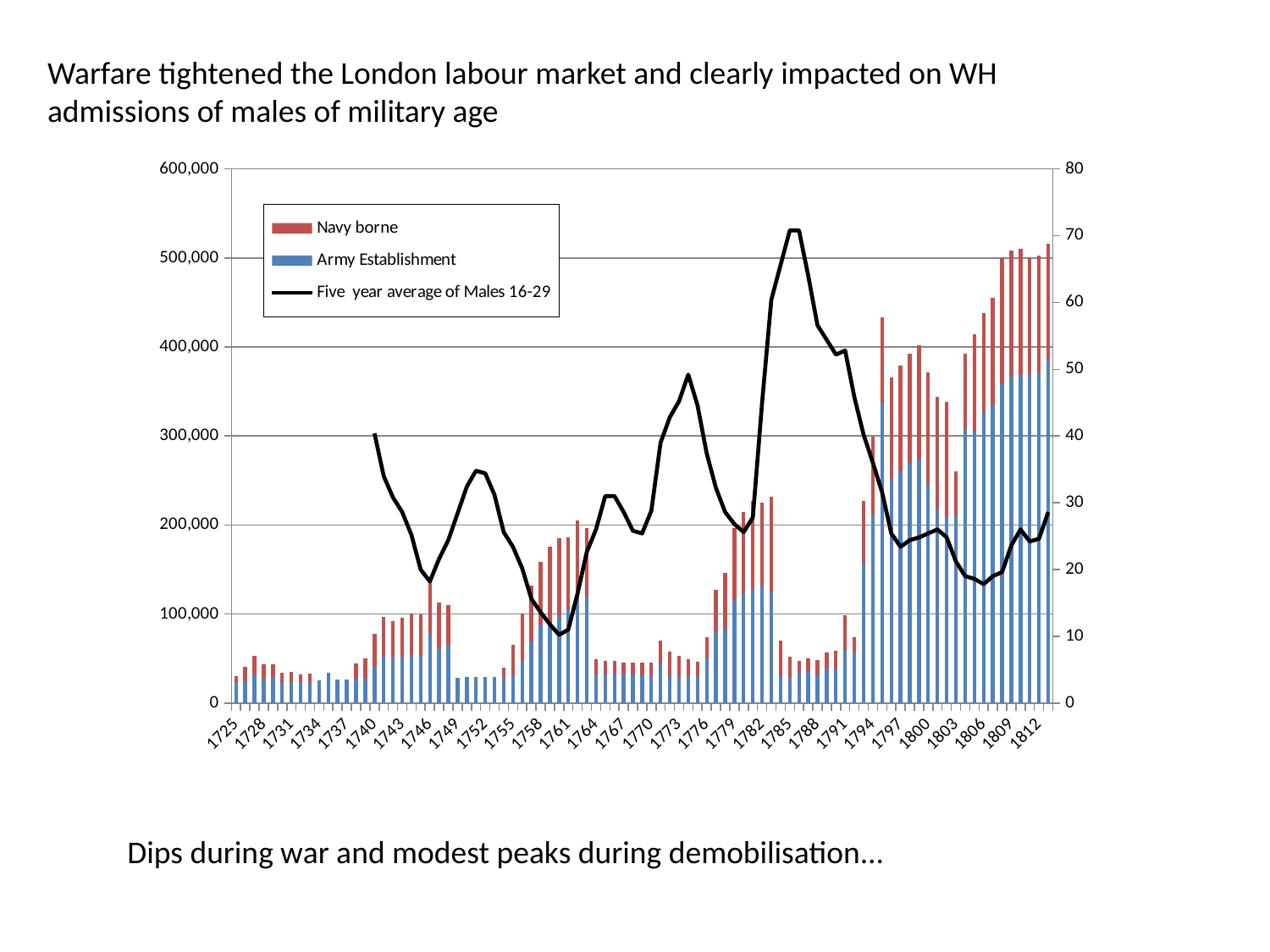
Is the total stacked bar for 1725 greater or less than 100,000? less Is the Five year average of Males 16-29 at 1761 greater or less than 20? less Does the Five year average of Males 16-29 line rise or fall between 1782 and 1785? Rise Around which labelled year does the Five year average of Males 16-29 line reach its highest point? 1785 How many series does the legend list? 3 What kind of chart is shown on the slide? A combined stacked bar and line chart Is the total stacked bar (Army Establishment plus Navy borne) for 1797 greater or less than 400,000? less Does the Five year average of Males 16-29 line rise or fall between 1785 and 1791? Fall Which has the larger total stacked bar, 1797 or 1761? 1797 Which series is drawn as a black line? Five year average of Males 16-29 What colour are the Navy borne bars? Red